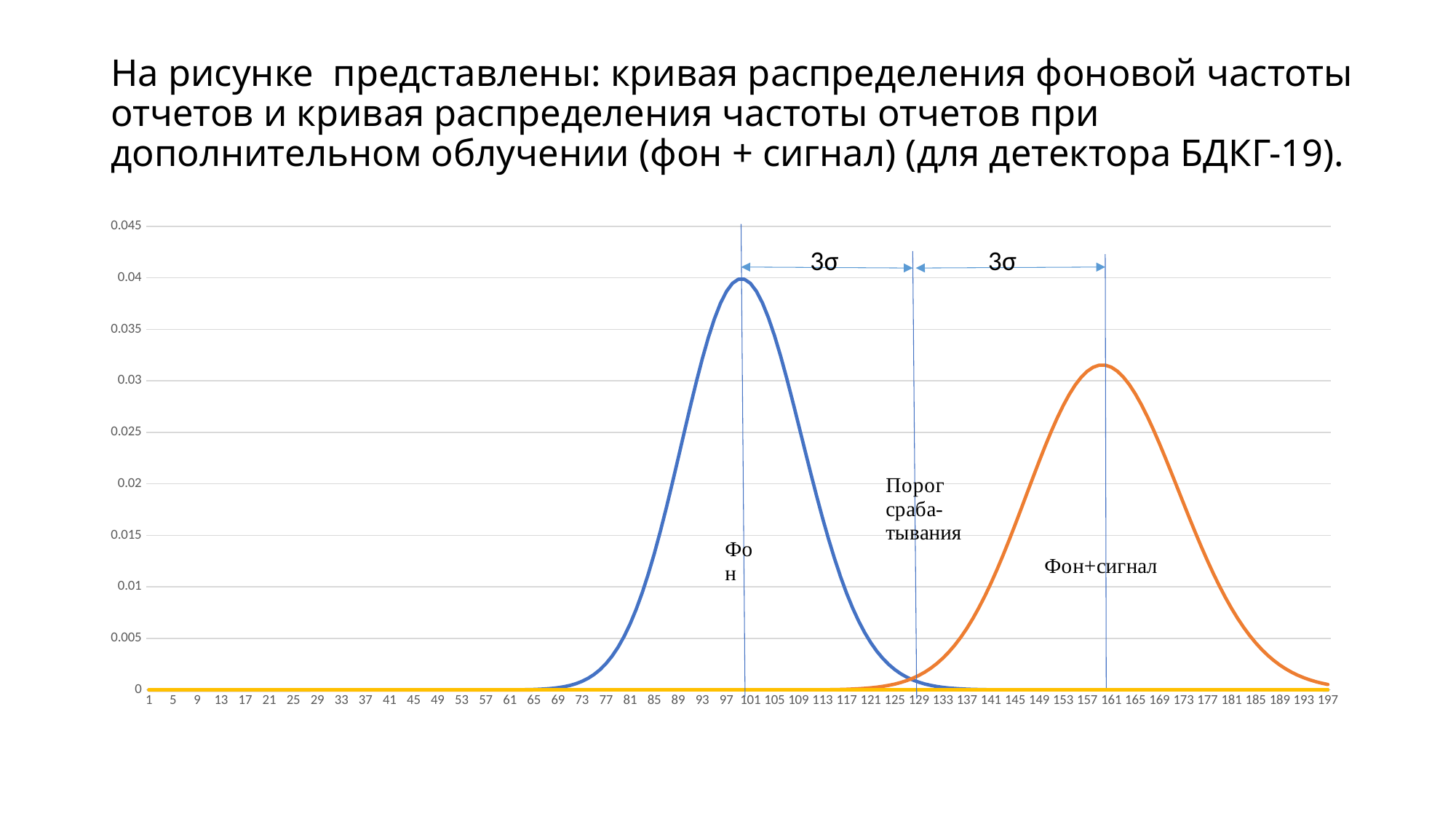
Is the peak of the Фон+сигнал curve located at an x value greater or less than 140? greater What kind of chart is shown on the slide? line chart What is the highest value shown on the y axis? 0.045 How many bell-shaped curves are plotted on the chart? 2 Is the peak value of the Фон+сигнал curve greater or less than 0.025? greater Is the peak value of the Фон+сигнал curve greater or less than 0.035? less What colour is the Фон+сигнал curve? orange Which curve reaches the higher peak, Фон or Фон+сигнал? Фон Which curve has its peak further to the right along the x axis, Фон or Фон+сигнал? Фон+сигнал